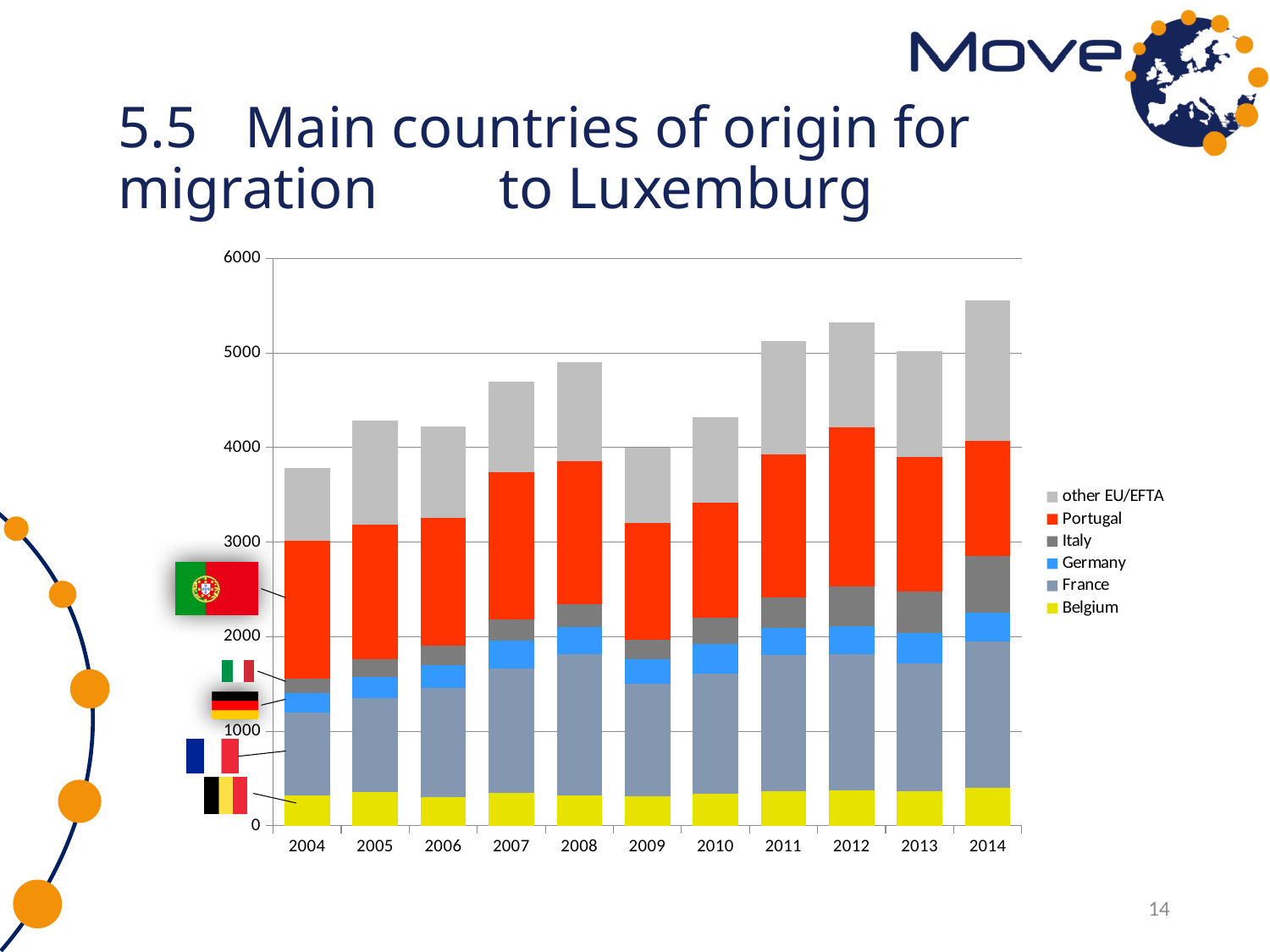
What kind of chart is shown on the slide? stacked bar chart How many series does the chart legend list? 6 Which year has the tallest stacked bar (highest total migration)? 2014 Is the total for 2007 greater or less than 5000? less Is the total for 2004 greater or less than 4000? less Which year has the shortest stacked bar (lowest total migration)? 2004 Which year has the larger total, 2008 or 2010? 2008 How many years are shown on the x axis of the chart? 11 Do the total bar heights generally rise or fall from 2004 to 2014? rise Which series is shown in red in the chart? Portugal Which year has the larger total, 2009 or 2011? 2011 Is the total for 2014 greater or less than 5000? greater